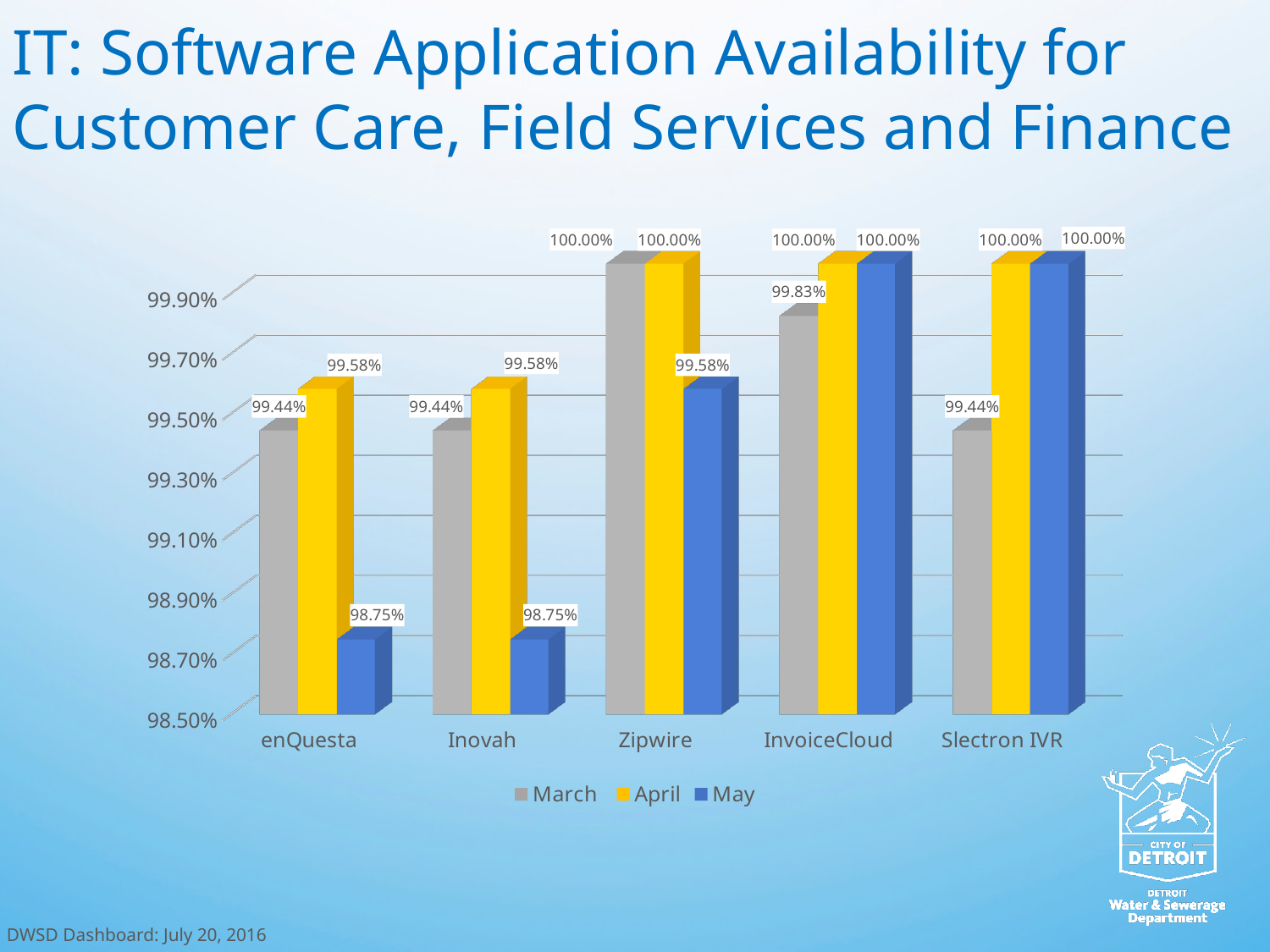
What is the May availability value for Inovah? 98.75% What is the difference between the April and May values for enQuesta? 0.83% Which application has the highest March availability value? Zipwire Which is larger for InvoiceCloud: the March value or the April value? April What kind of chart is shown on the slide? Bar chart What is the March availability value for enQuesta? 99.44% Which application has the lowest May availability value? enQuesta and Inovah (98.75%) What is the April availability value for Slectron IVR? 100.00% What is the March availability value for InvoiceCloud? 99.83% How many series does the legend list? 3 How many applications are shown on the x axis? 5 What is the May availability value for Zipwire? 99.58%